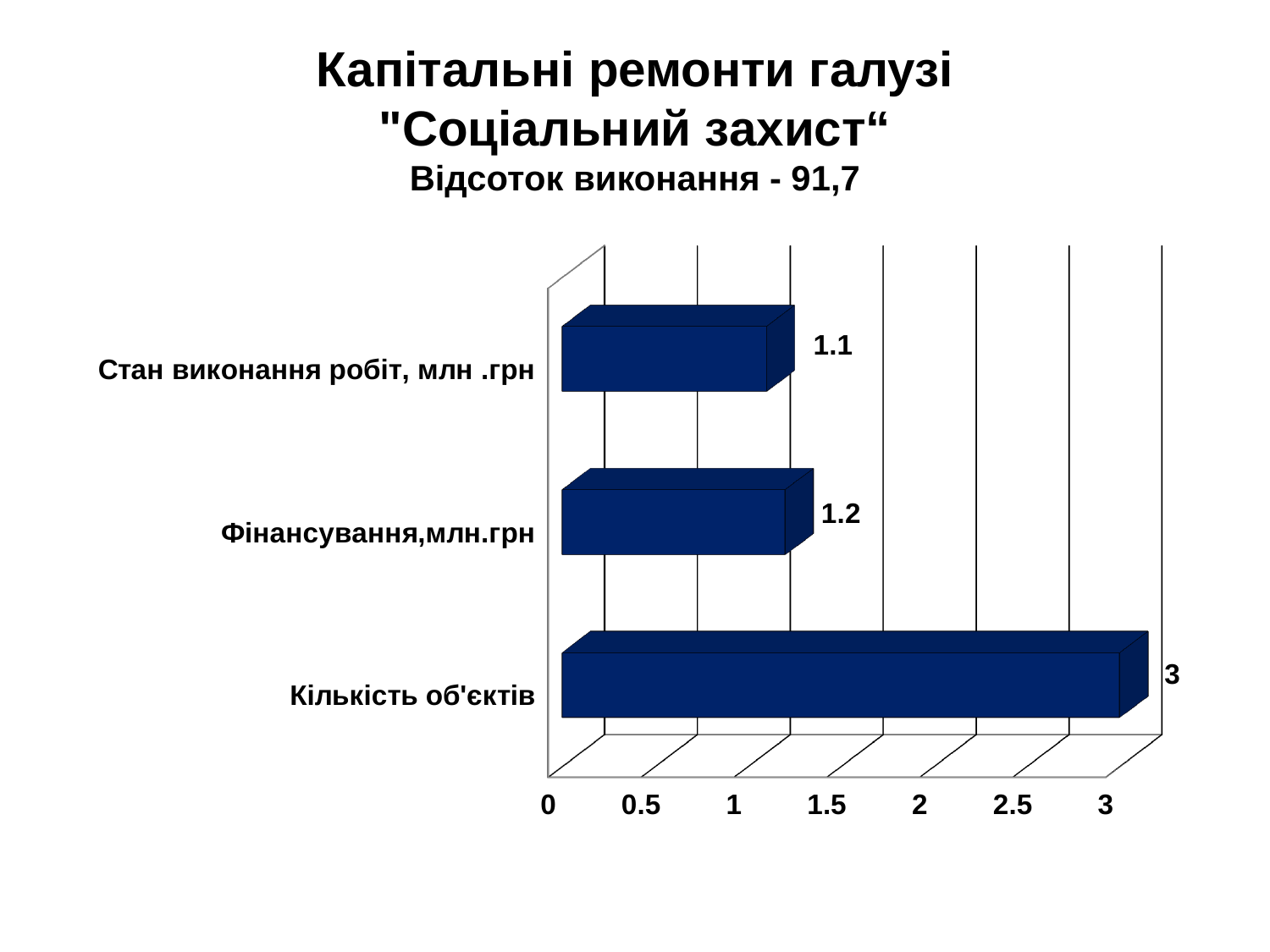
What is the difference between the values for Фінансування,млн.грн and Стан виконання робіт, млн .грн? 0.1 Which category has the highest value? Кількість об'єктів What is the difference between the values for Кількість об'єктів and Фінансування,млн.грн? 1.8 What is the value for Кількість об'єктів? 3 What kind of chart is shown on the slide? bar chart Which category has the lowest value? Стан виконання робіт, млн .грн What percentage of completion (Відсоток виконання) is stated in the chart title? 91,7 How many categories are shown in the chart? 3 What is the value for Стан виконання робіт, млн .грн? 1.1 Which is larger: the value for Кількість об'єктів or the value for Стан виконання робіт, млн .грн? Кількість об'єктів What is the value for Фінансування,млн.грн? 1.2 Is the value for Фінансування,млн.грн greater or less than 2? less